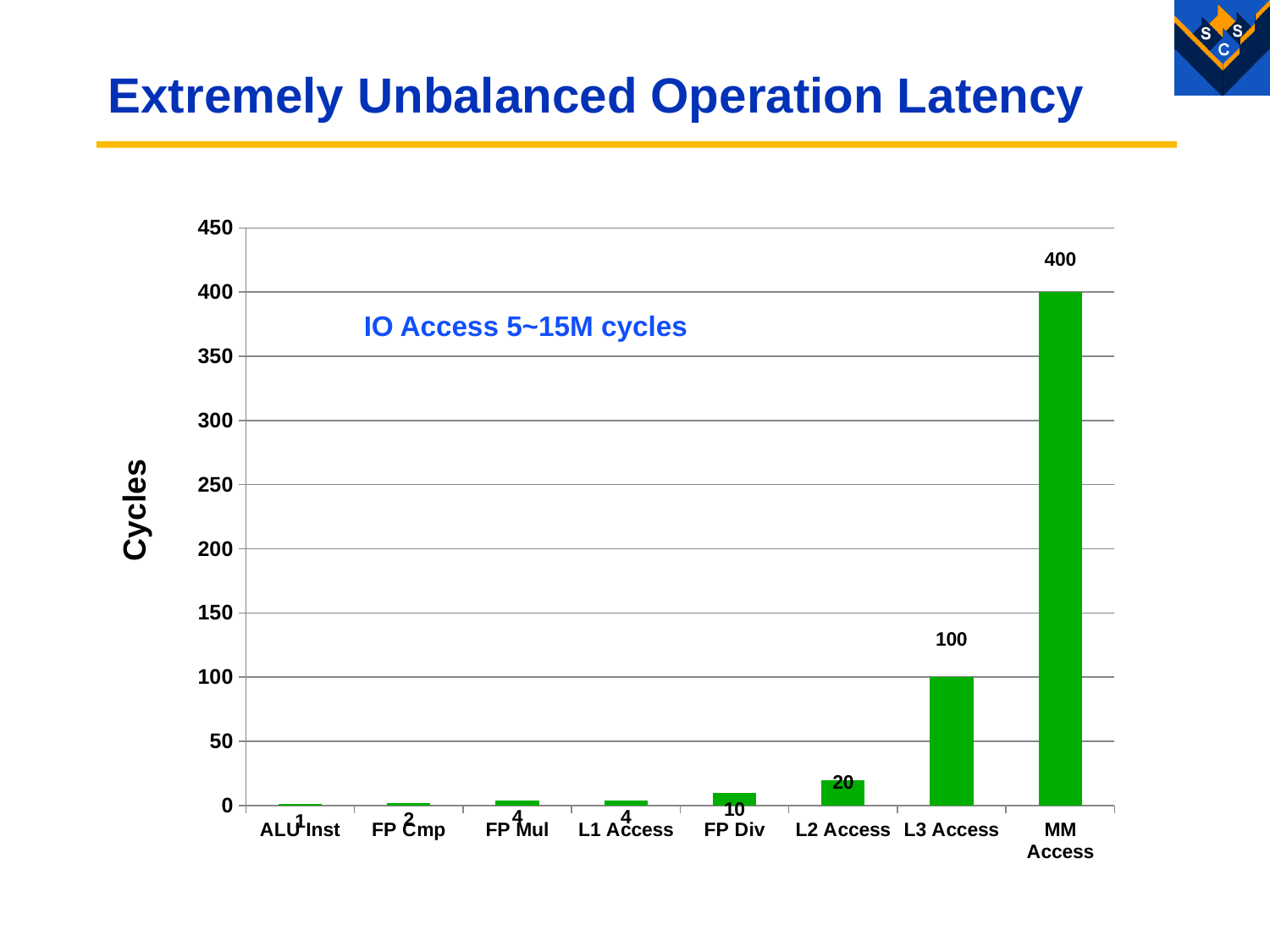
What is the label of the y axis? Cycles What is the value for MM Access? 400 How many categories are shown on the x axis? 8 Is the value for L3 Access greater or less than 150? less What is the value for L3 Access? 100 What kind of chart is shown on the slide? bar chart What is the difference between the values for MM Access and L3 Access? 300 Which category has the lowest value? ALU Inst What is the value for FP Div? 10 Which category has the highest value? MM Access Which is larger, the value for L2 Access or the value for FP Div? L2 Access What is the value for L2 Access? 20